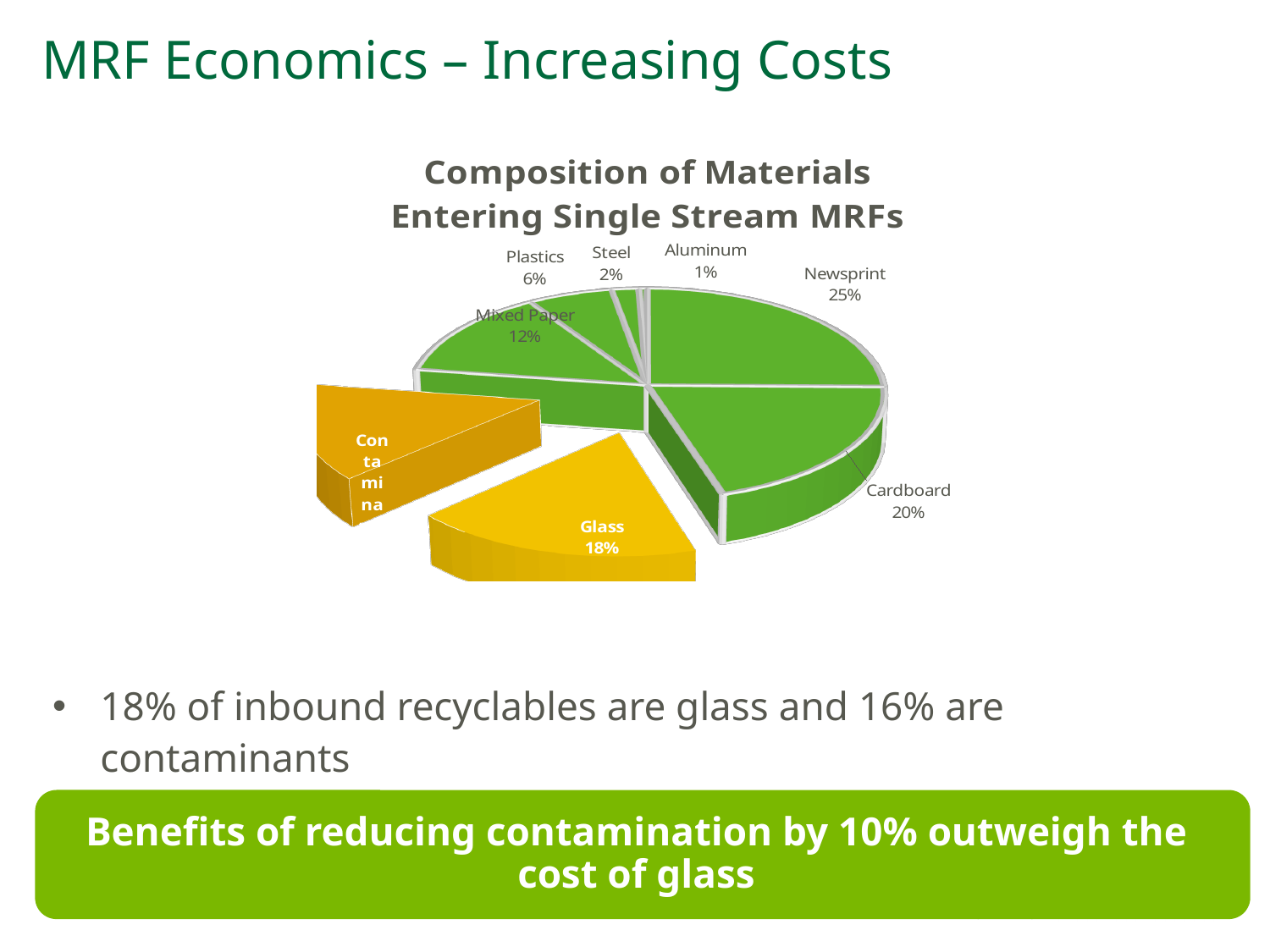
What percentage of materials entering single stream MRFs is Newsprint? 25% What share does Cardboard have in the Composition of Materials pie chart? 20% What percentage is shown for Glass in the pie chart? 18% Which material has the smallest share in the pie chart? Aluminum What is the title of the chart on the slide? Composition of Materials Entering Single Stream MRFs What percentage is shown for Aluminum in the pie chart? 1% Which material has the largest share in the pie chart? Newsprint What percentage is shown for Steel in the pie chart? 2% How many percentage points larger is the Newsprint share than the Cardboard share? 5 percentage points Which has the larger share, Glass or Mixed Paper? Glass What percentage is shown for Mixed Paper? 12% What type of chart is shown on the slide? Pie chart